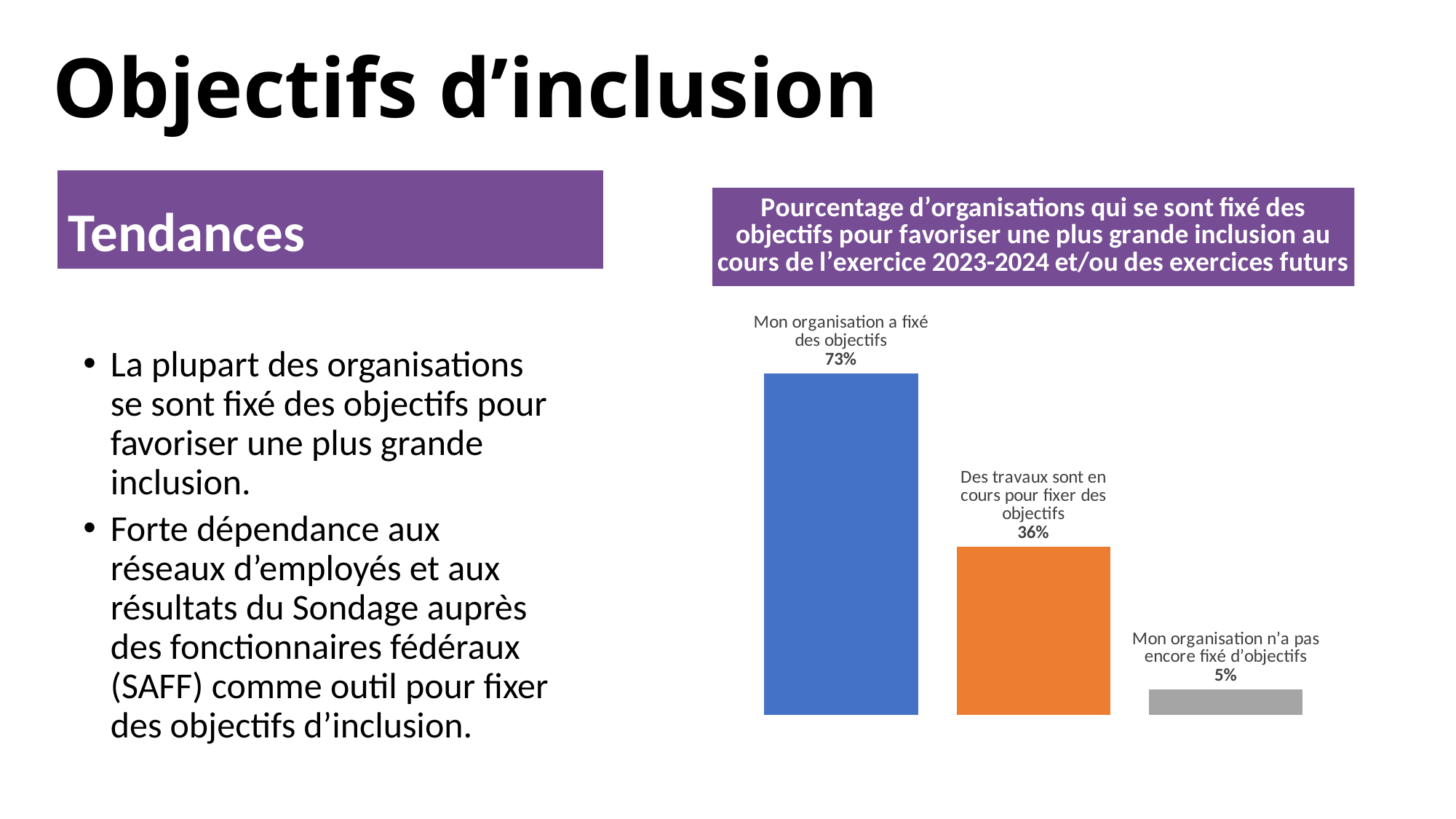
What is the value shown for "Des travaux sont en cours pour fixer des objectifs"? 36% What is the difference between the values for "Des travaux sont en cours pour fixer des objectifs" and "Mon organisation n'a pas encore fixé d'objectifs"? 31% How many categories are shown in the chart? 3 Which is larger: the value for "Des travaux sont en cours pour fixer des objectifs" or for "Mon organisation n'a pas encore fixé d'objectifs"? Des travaux sont en cours pour fixer des objectifs What percentage of organisations answered "Mon organisation a fixé des objectifs"? 73% What is the difference between the values for "Mon organisation a fixé des objectifs" and "Des travaux sont en cours pour fixer des objectifs"? 37% What is the value shown for "Mon organisation n'a pas encore fixé d'objectifs"? 5% What kind of chart is shown on the slide? Bar chart What colour is the bar for "Des travaux sont en cours pour fixer des objectifs"? Orange Do the values rise or fall from left to right across the chart? Fall Which category has the lowest value in the chart? Mon organisation n'a pas encore fixé d'objectifs Which category has the highest value in the chart? Mon organisation a fixé des objectifs